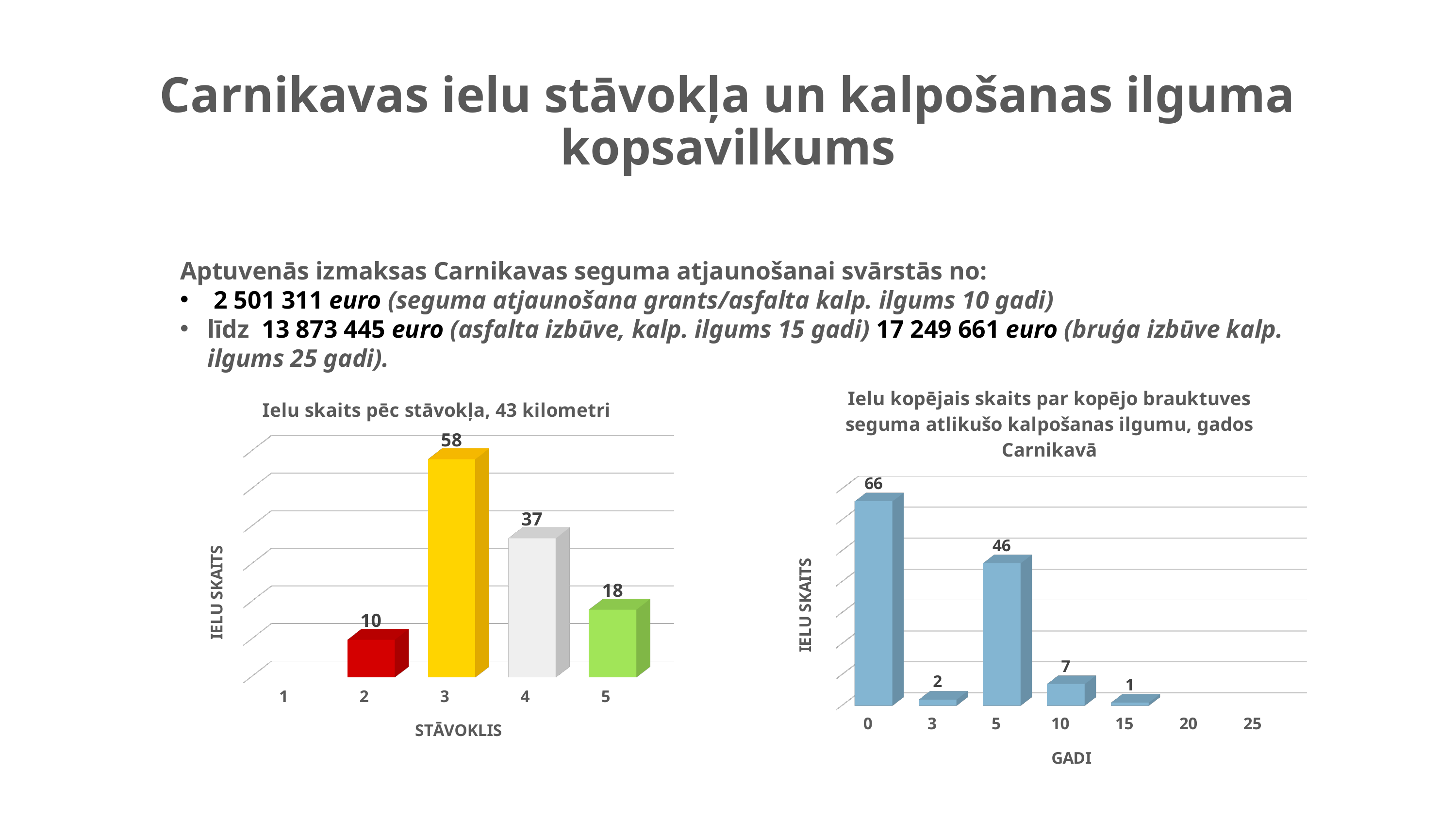
In the right chart about remaining service life in Carnikava, what is the value for 0 gadi? 66 In the right chart about remaining service life in Carnikava, what is the difference between the values for 0 gadi and 5 gadi? 20 In the left chart 'Ielu skaits pēc stāvokļa, 43 kilometri', which is larger: the value for stāvoklis 2 or stāvoklis 5? 5 In the right chart about remaining service life in Carnikava, which gadi category has the highest value? 0 In the right chart about remaining service life in Carnikava, what is the value for 5 gadi? 46 In the left chart 'Ielu skaits pēc stāvokļa, 43 kilometri', what is the value for stāvoklis 3? 58 In the right chart about remaining service life in Carnikava, how many categories are shown on the x axis? 7 In the left chart 'Ielu skaits pēc stāvokļa, 43 kilometri', what kind of chart is shown? bar chart In the left chart 'Ielu skaits pēc stāvokļa, 43 kilometri', what is the value for stāvoklis 5? 18 In the left chart 'Ielu skaits pēc stāvokļa, 43 kilometri', which stāvoklis category has the highest value? 3 In the left chart 'Ielu skaits pēc stāvokļa, 43 kilometri', what is the difference between the values for stāvoklis 3 and stāvoklis 4? 21 In the right chart about remaining service life in Carnikava, what is the value for 10 gadi? 7